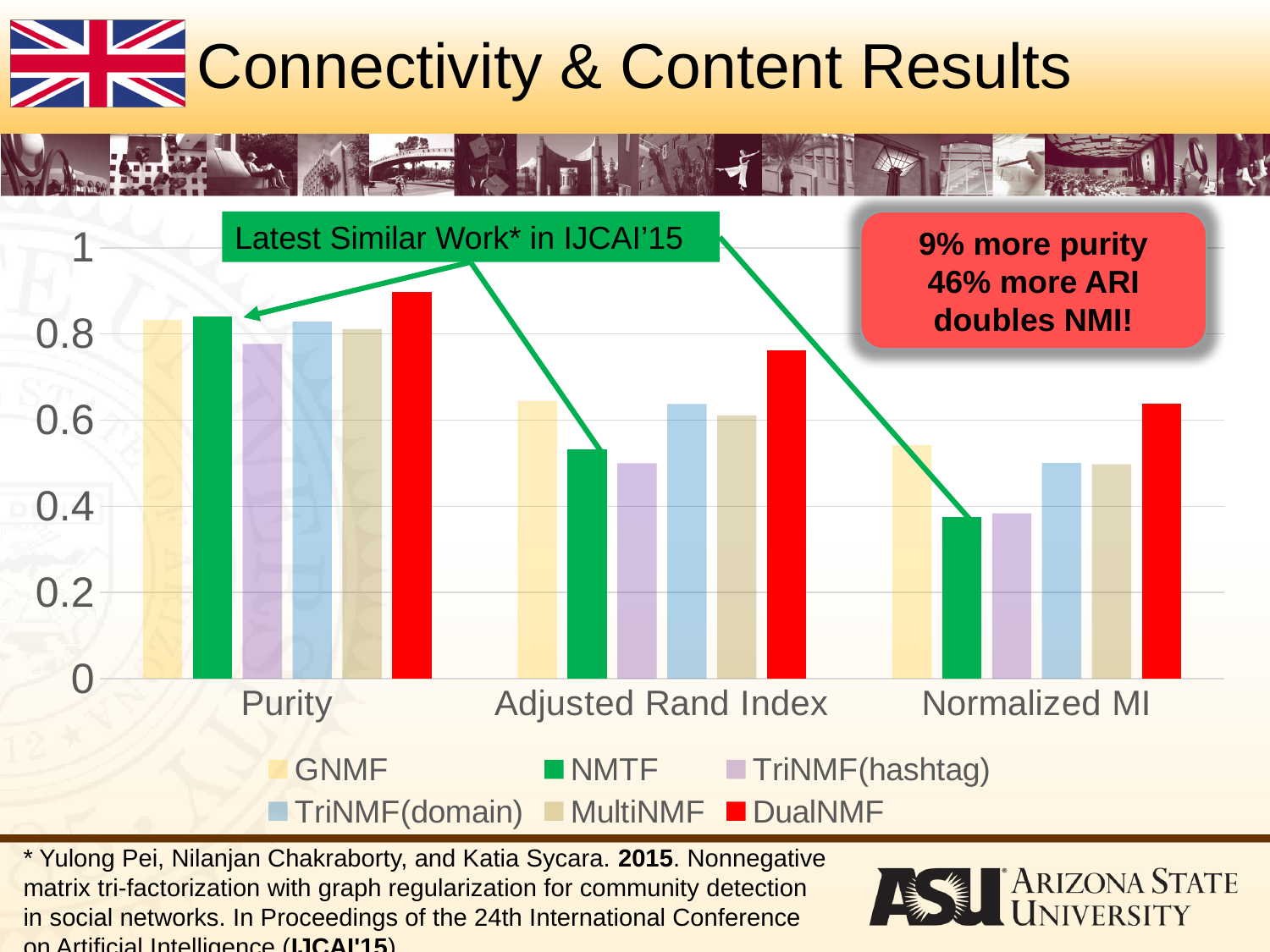
Which series has the highest value for Purity? DualNMF For Normalized MI, which is larger: the value of GNMF or the value of NMTF? GNMF What kind of chart is shown on the slide? bar chart What colour are the DualNMF bars in the chart? red How many categories are shown on the x axis of the chart? 3 Which series has the highest value for Adjusted Rand Index? DualNMF How many series does the chart's legend list? 6 For Adjusted Rand Index, which is larger: the value of DualNMF or the value of NMTF? DualNMF Which series has the highest value for Normalized MI? DualNMF Is the value of DualNMF for Purity greater or less than 0.8? greater Is the value of DualNMF for Adjusted Rand Index greater or less than 0.6? greater Is the value of NMTF for Normalized MI greater or less than 0.4? less